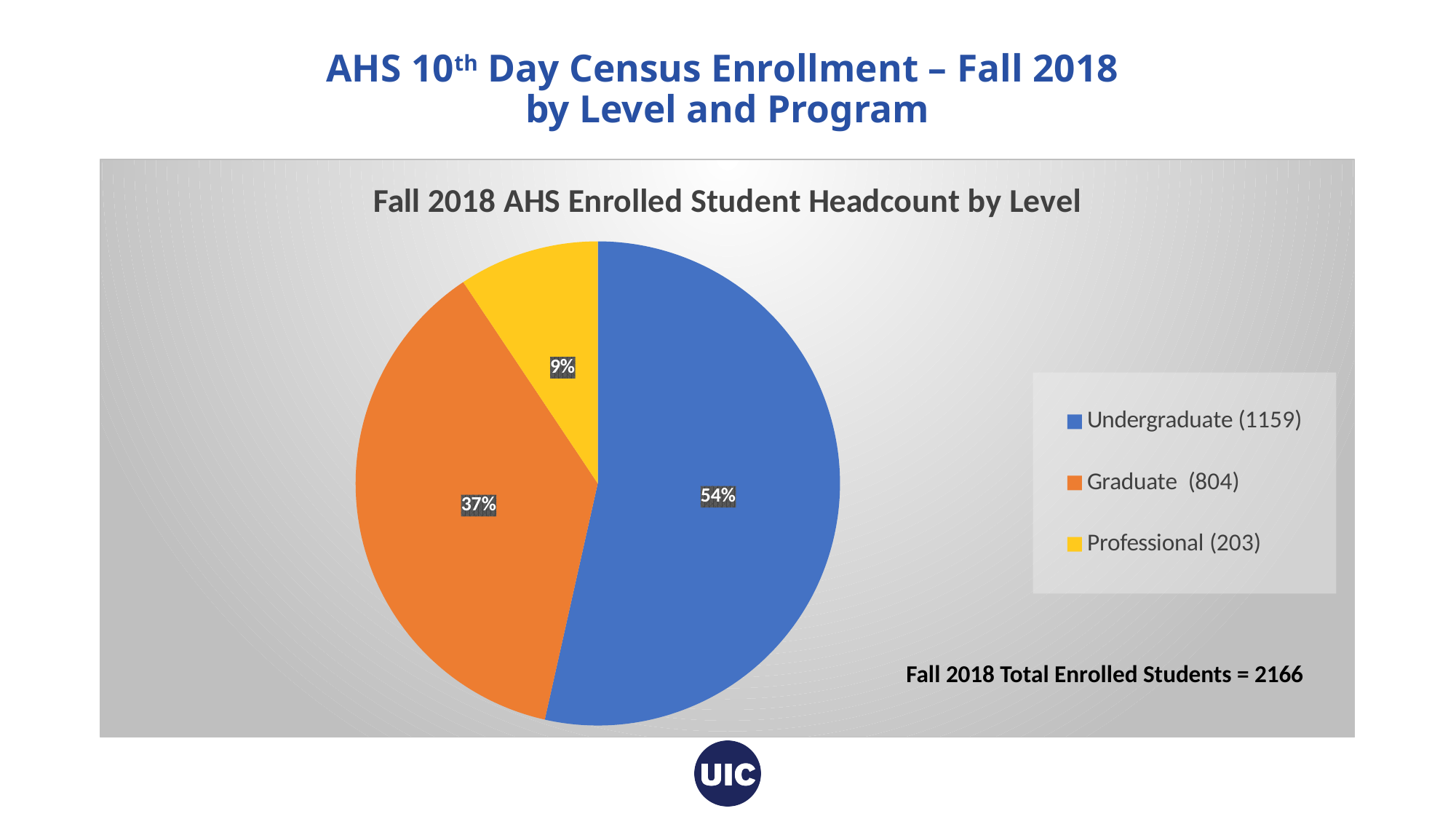
What percentage share of the pie does Professional have? 9% Which level has the smallest slice of the pie? Professional What is the headcount for Graduate students shown in the legend? 804 What percentage share of the pie does Undergraduate have? 54% What kind of chart is shown on the slide? pie chart Which level has the largest slice of the pie? Undergraduate What is the title of the chart? Fall 2018 AHS Enrolled Student Headcount by Level Which slice is larger, Graduate or Professional? Graduate How many slices does the pie chart have? 3 What percentage share of the pie does Graduate have? 37% What is the difference in percentage points between the Undergraduate and Graduate slices? 17 How many entries does the legend list? 3